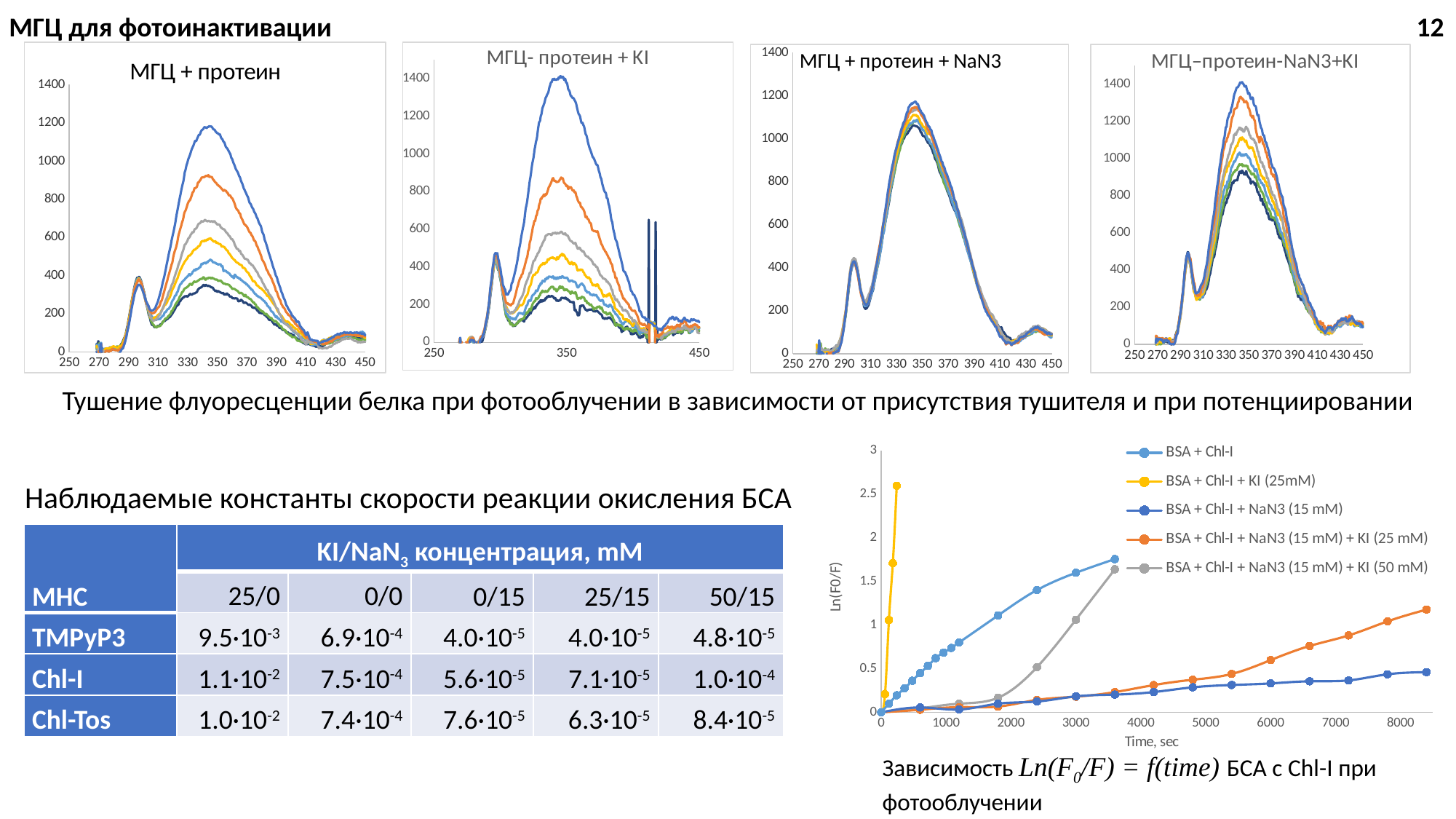
In the bottom-right Ln(F0/F) chart, do the values of the BSA + Chl-I + NaN3 (15 mM) + KI (25 mM) series rise or fall as time increases? rise In the chart titled 'МГЦ + протеин + NaN3', is the peak of the lowest curve greater or less than 800? greater In the bottom-right Ln(F0/F) chart, at 3600 sec, which series has the larger value: BSA + Chl-I or BSA + Chl-I + NaN3 (15 mM)? BSA + Chl-I In the chart titled 'МГЦ- протеин + KI', is the peak of the highest curve greater or less than 1200? greater In the bottom-right Ln(F0/F) chart, is the value of the BSA + Chl-I + NaN3 (15 mM) + KI (25 mM) series at 8400 sec greater or less than 1? greater In the bottom-right Ln(F0/F) chart, how many series does the legend list? 5 In the bottom-right Ln(F0/F) chart, what is the label of the x axis? Time, sec What is the title of the top-right spectral chart? МГЦ–протеин-NaN3+KI In the bottom-right Ln(F0/F) chart, which series rises most steeply with time? BSA + Chl-I + KI (25mM) What kind of chart is the bottom-right chart titled with Ln(F0/F) versus Time, sec? line chart